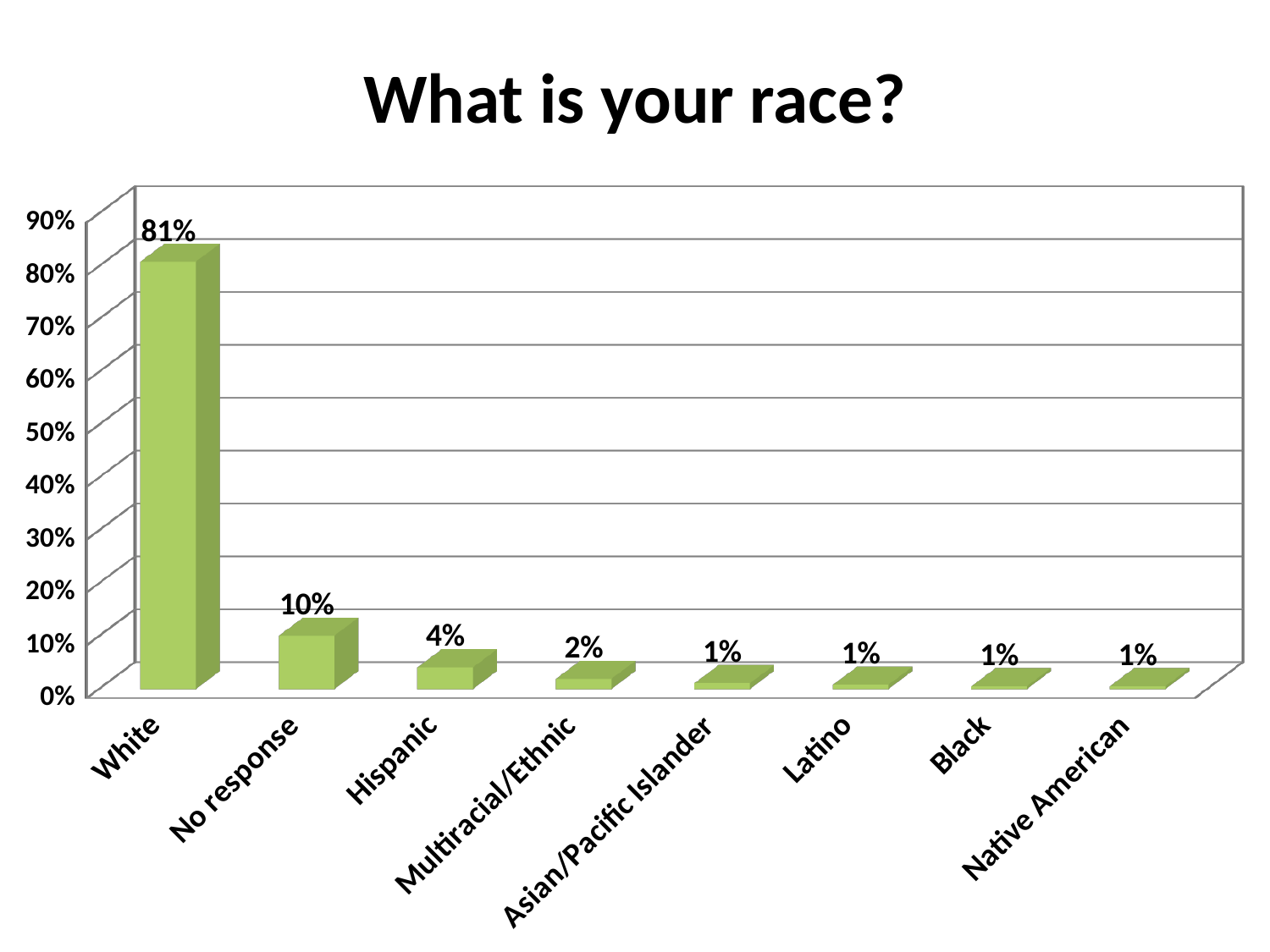
What percentage of respondents answered White? 81% Which is larger, the value for No response or the value for Hispanic? No response How many categories are shown on the x axis? 8 What is the title of the chart? What is your race? What percentage of respondents gave no response? 10% What is the difference between the White and No response values? 71% What kind of chart is shown on the slide? Bar chart What is the difference between the Hispanic and Multiracial/Ethnic values? 2% Is the value for White greater or less than 80%? greater What is the value for Multiracial/Ethnic? 2% What is the value for Hispanic? 4% Which category has the highest value? White